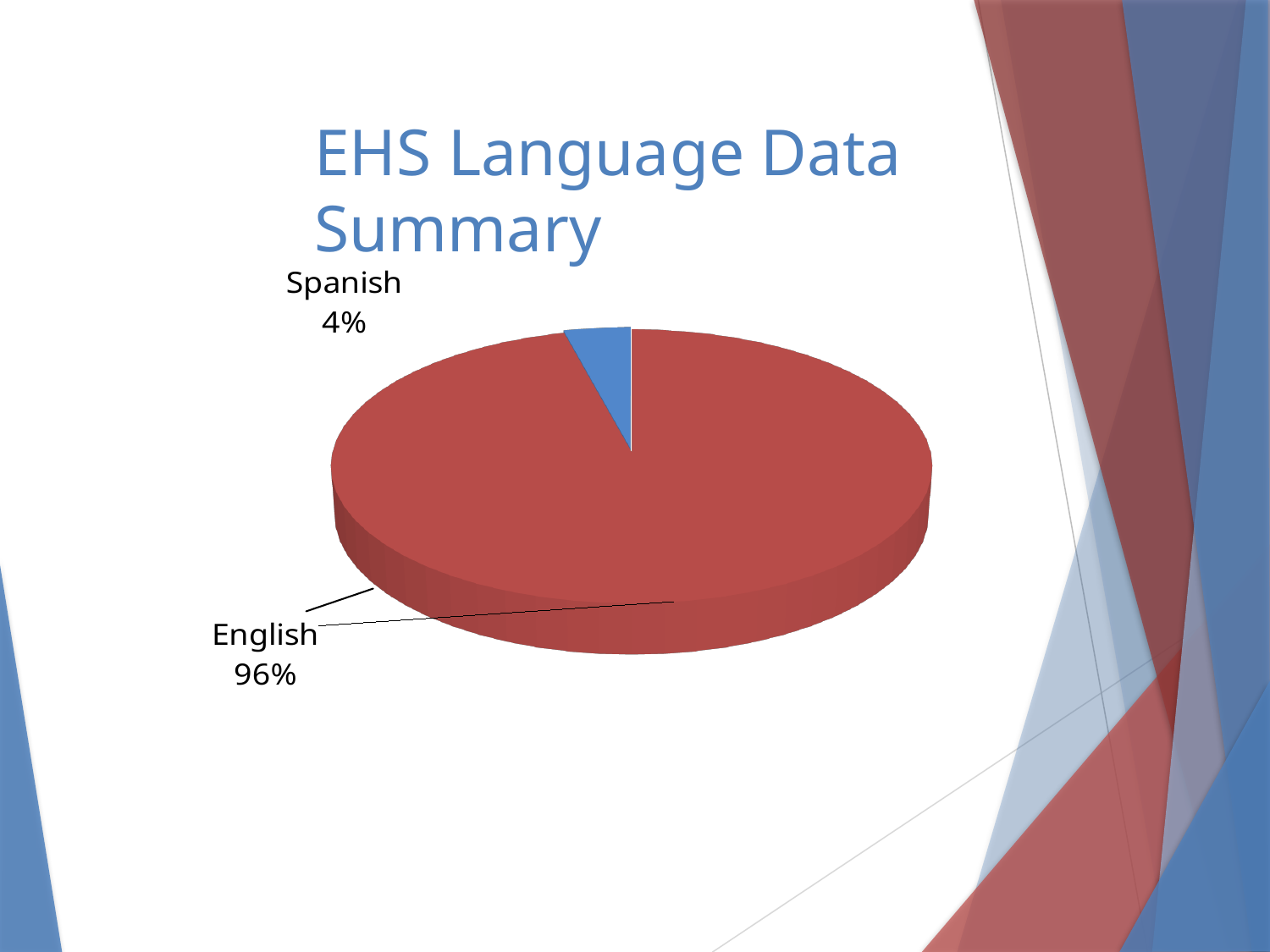
What share of the pie does English represent? 96% What is the title of the slide containing the chart? EHS Language Data Summary How many slices does the pie chart have? 2 What share of the pie does Spanish represent? 4% Which language has the largest slice of the pie? English Which is larger, the share for English or the share for Spanish? English What colour is the Spanish slice of the pie? Blue What kind of chart is shown on the slide? Pie chart Which language has the smallest slice of the pie? Spanish What is the difference in percentage points between the English and Spanish shares? 92